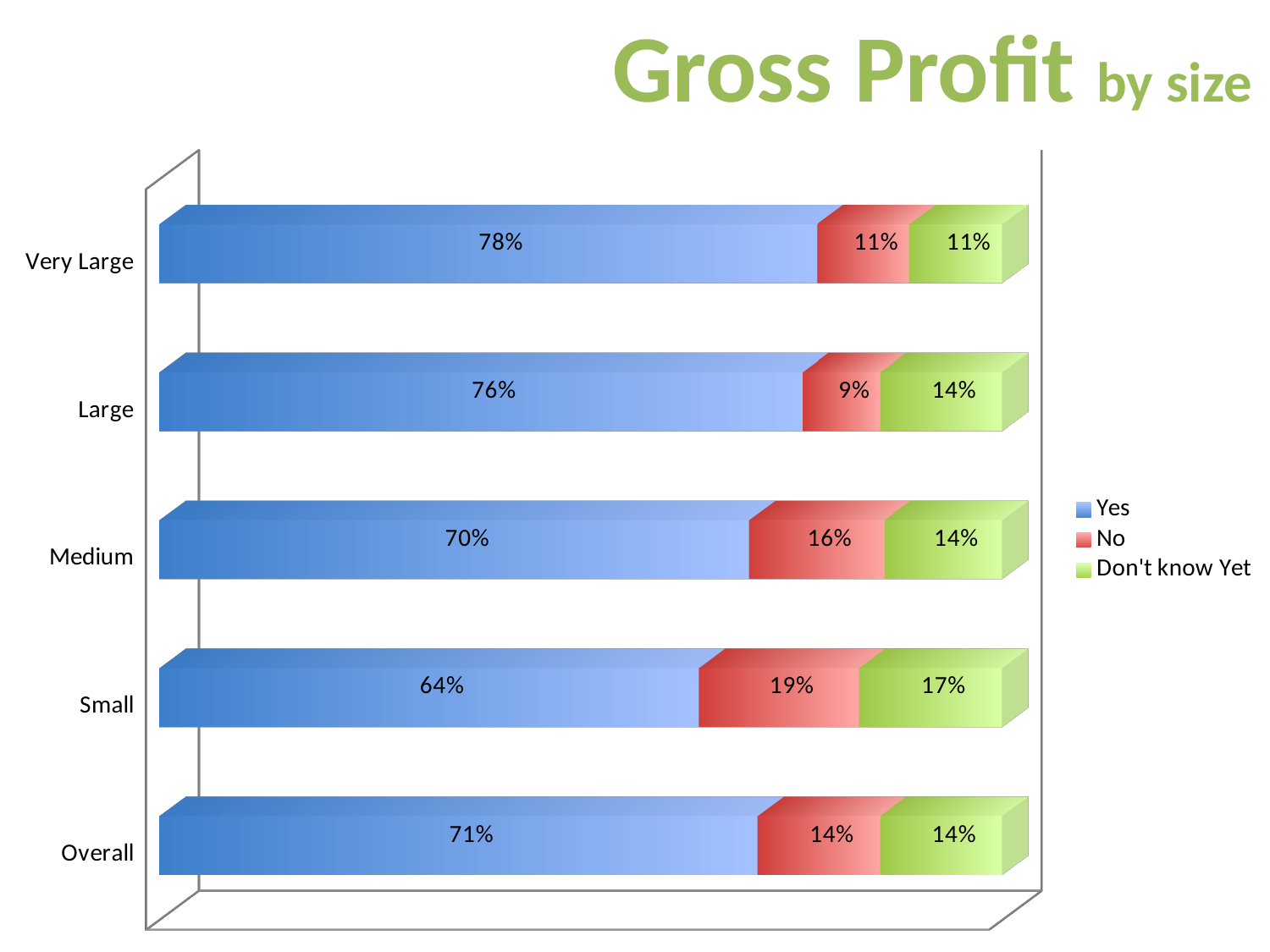
What is the title of the slide? Gross Profit by size Which category has the highest Yes value? Very Large Which is larger, the No value for Medium or the No value for Large? Medium How many series does the legend list? 3 What is the No value for the Small category? 19% What is the difference between the Yes values for Very Large and Small? 14% What kind of chart is shown on the slide? Stacked bar chart What is the Yes value for Overall? 71% How many categories are shown on the chart? 5 What is the Don't know Yet value for Large? 14% Which category has the lowest Yes value? Small What percentage of Very Large companies answered Yes? 78%